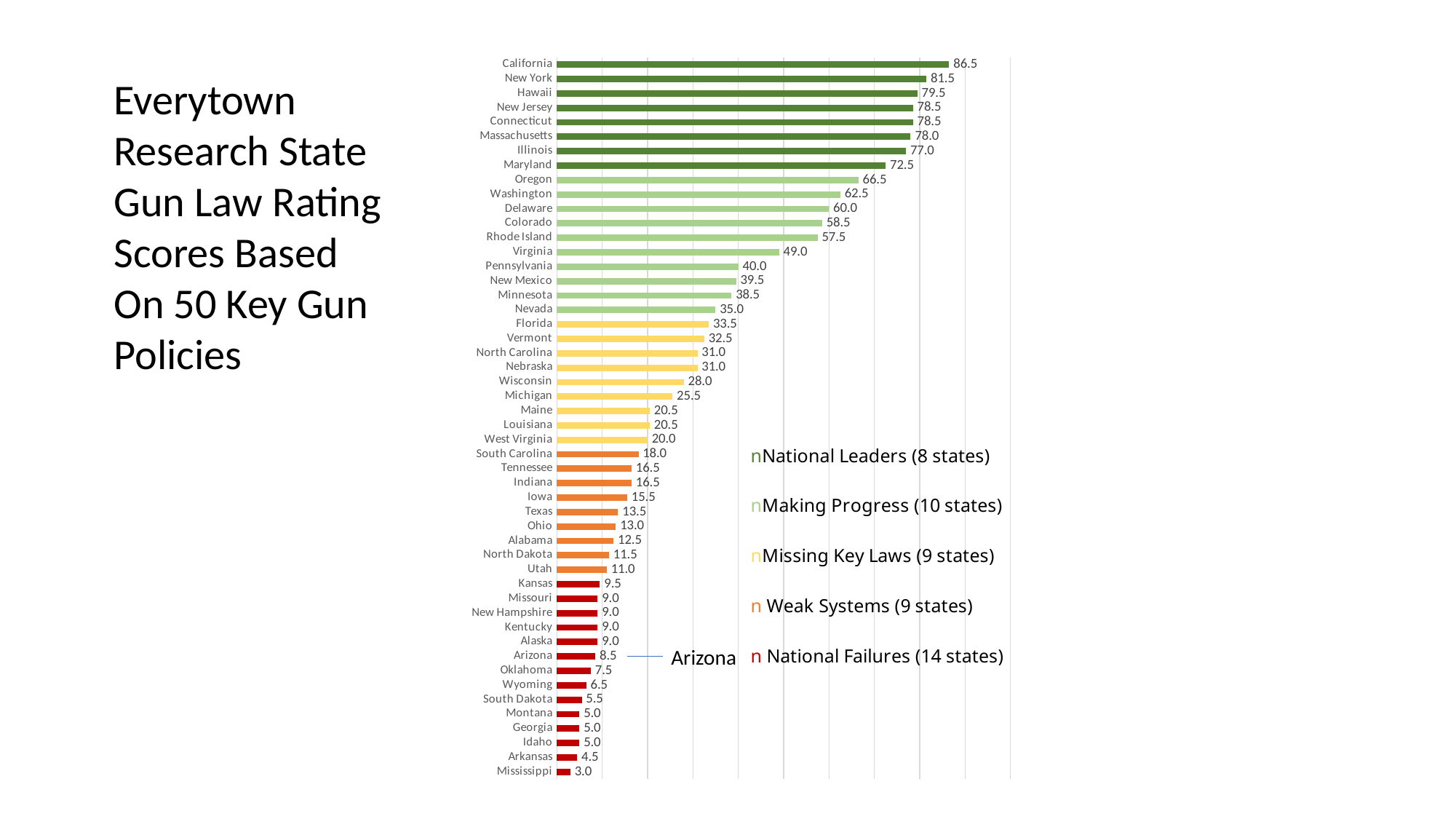
Which state has the highest gun law rating score? California How many states are in the National Failures group according to the legend? 14 states Which state has the lowest gun law rating score? Mississippi Which state has a higher score, Oregon or Washington? Oregon What is the gun law rating score for Virginia? 49.0 What type of chart is shown on the slide? Bar chart What is the gun law rating score for Arizona? 8.5 What is the gun law rating score for California? 86.5 What is the difference between the scores of New York and Hawaii? 2.0 Which state is called out with a label next to its bar? Arizona How many groups does the legend list? 5 What is the difference between the scores of Florida and Texas? 20.0